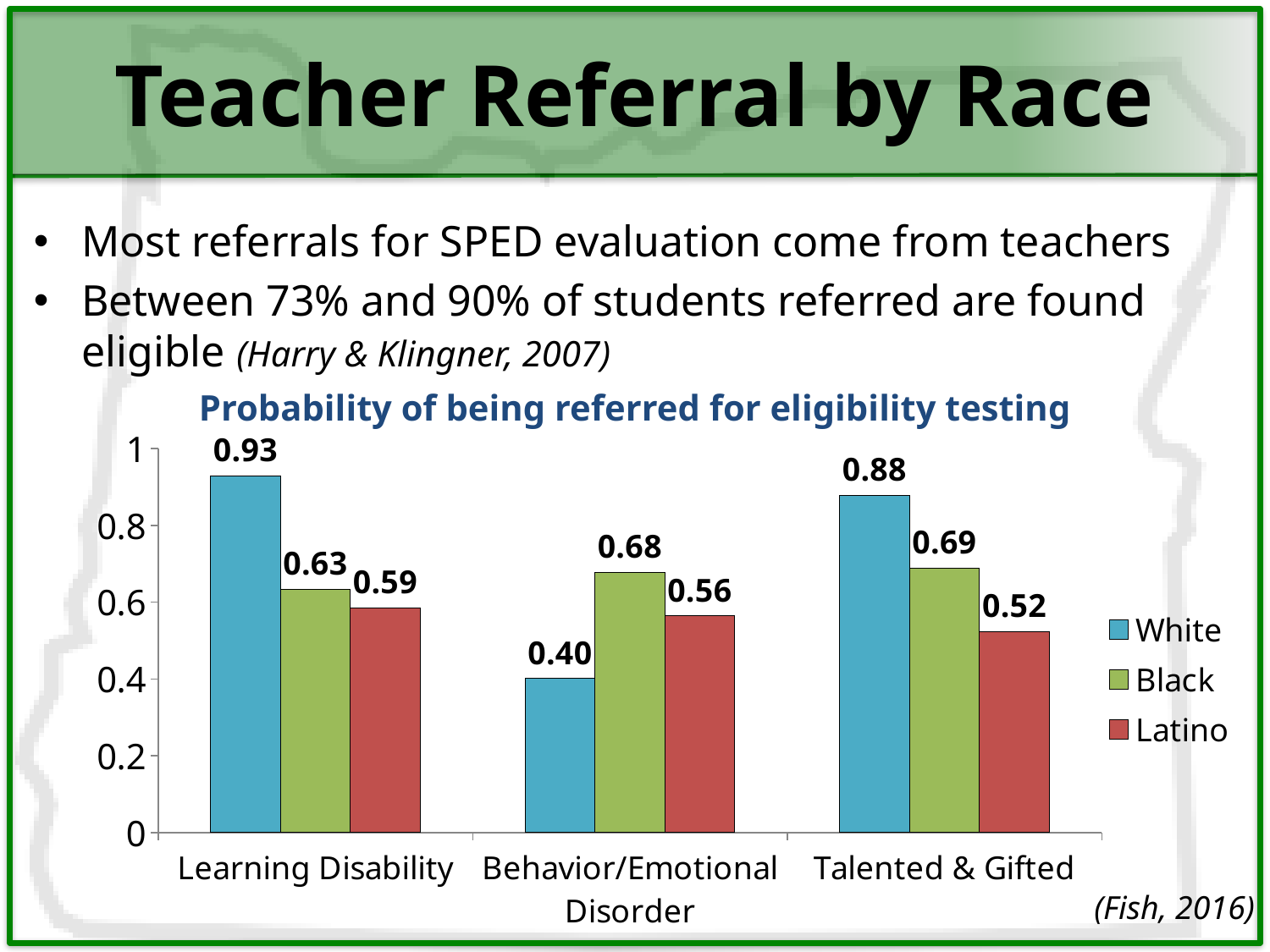
Which group has the highest value in the Behavior/Emotional Disorder category? Black Which group has the lowest value in the Learning Disability category? Latino Is the value for White students in the Behavior/Emotional Disorder category greater or less than 0.6? less What is the value for Latino students in the Talented & Gifted category? 0.52 How many series does the legend list? 3 How many categories are shown on the x axis? 3 What is the difference between the Black and Latino values in the Talented & Gifted category? 0.17 What kind of chart is shown on the slide? Bar chart What is the probability of being referred for eligibility testing for White students in the Learning Disability category? 0.93 What is the value for Black students in the Behavior/Emotional Disorder category? 0.68 What is the difference between the White and Black values in the Learning Disability category? 0.30 Which is larger: the White value for Learning Disability or the White value for Talented & Gifted? Learning Disability